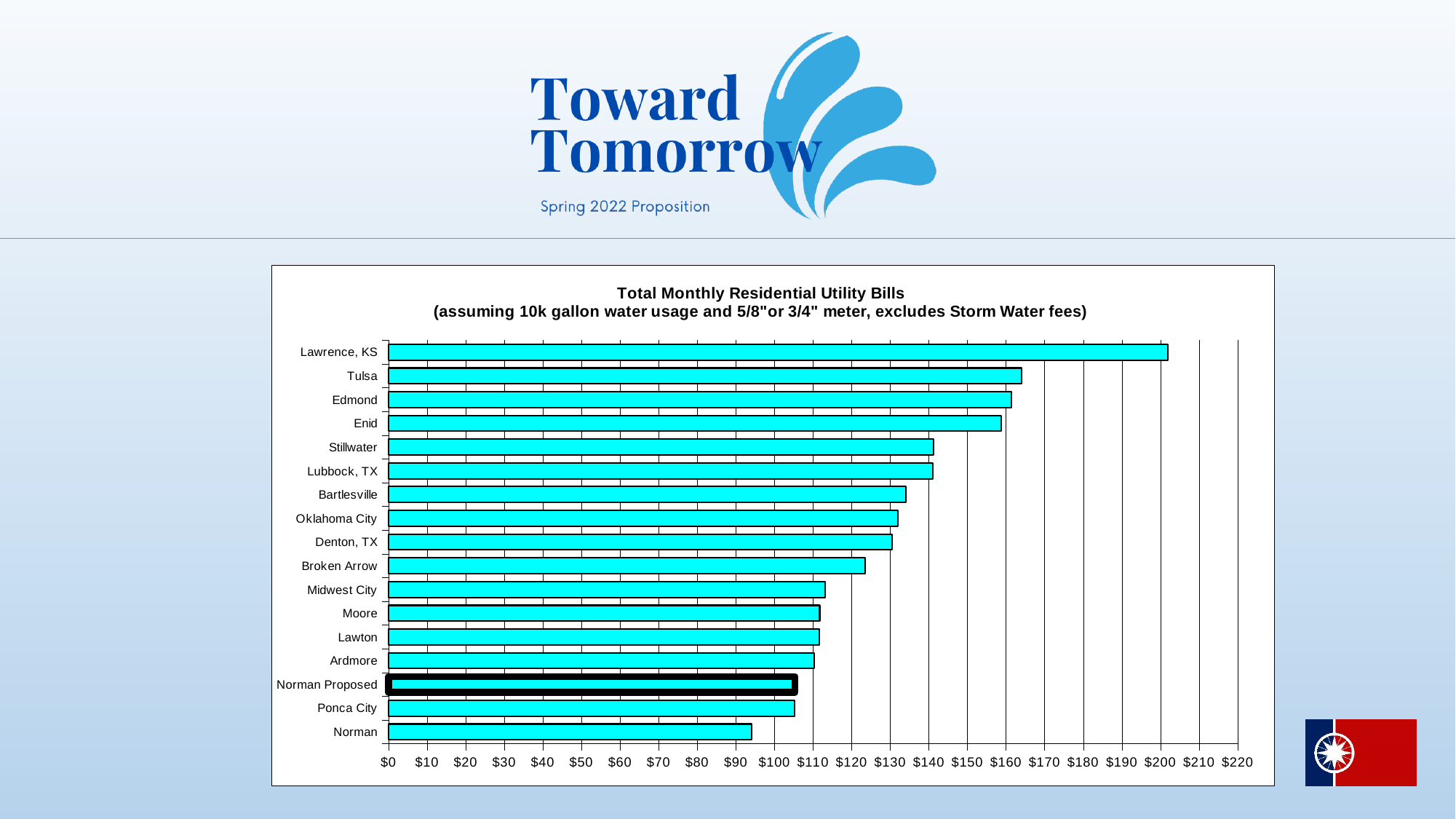
Which city has the highest total monthly residential utility bill? Lawrence, KS Which has a higher total monthly utility bill, Norman or Norman Proposed? Norman Proposed What kind of chart is shown on the slide? bar chart What is the highest value shown on the x axis? $220 How many cities are listed on the chart? 17 Which city has the lowest total monthly residential utility bill? Norman Which has a higher total monthly utility bill, Tulsa or Enid? Tulsa Is the value for Lawrence, KS greater or less than $200? greater Is the value for Broken Arrow greater or less than $130? less What is the first line of the chart's title? Total Monthly Residential Utility Bills Is the value for Norman greater or less than $100? less